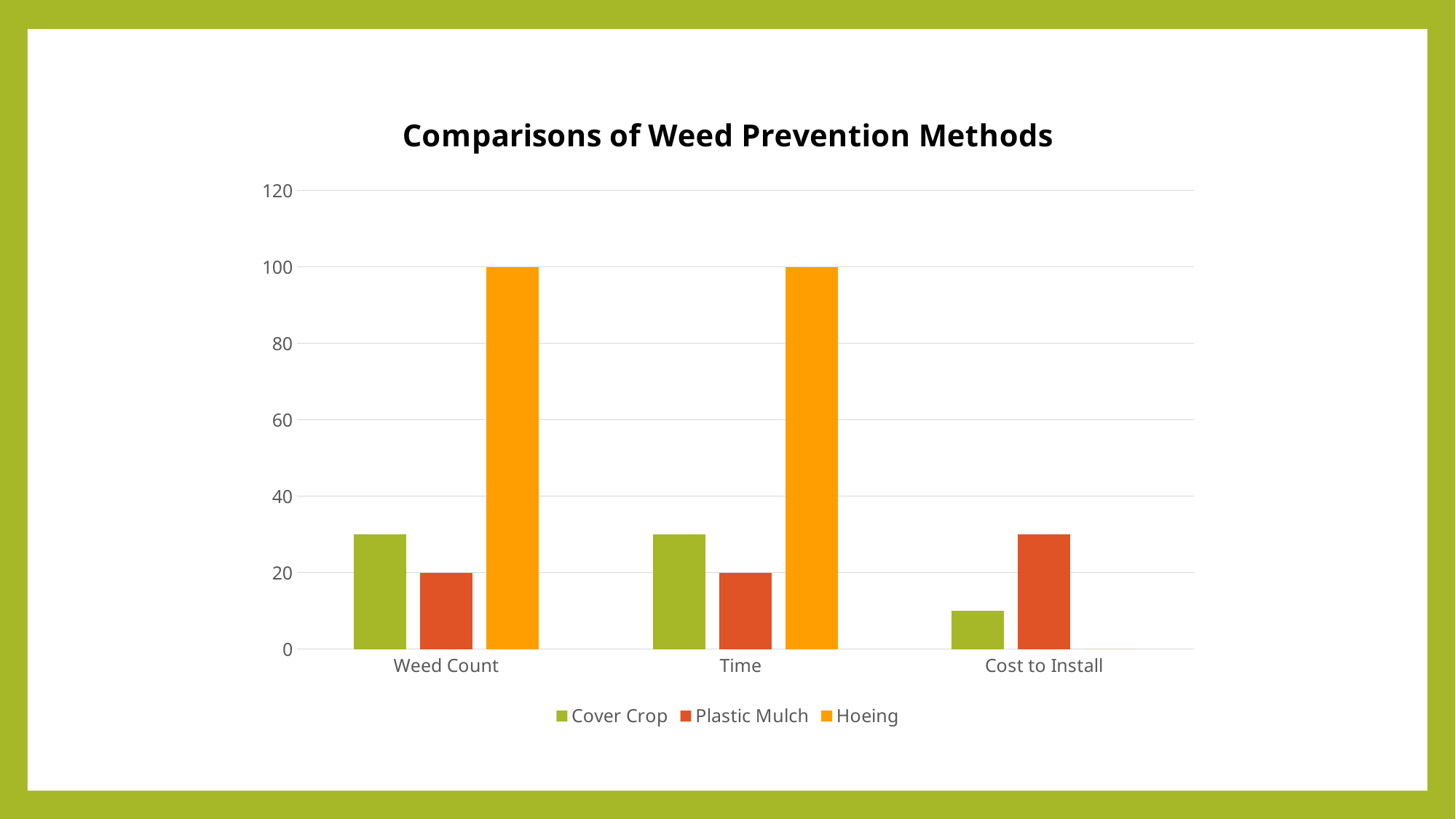
How many categories are shown on the x axis? 3 What is the difference between the Hoeing and Plastic Mulch values in the Weed Count category? 80 What is the value for Hoeing in the Weed Count category? 100 In the Time category, which is larger: Cover Crop or Plastic Mulch? Cover Crop How many series does the legend list? 3 Is the value for Cover Crop in the Weed Count category greater or less than 40? less What is the value for Hoeing in the Time category? 100 Is the value for Cover Crop in the Cost to Install category greater or less than 20? less What is the value for Plastic Mulch in the Time category? 20 Which method has the lowest value in the Weed Count category? Plastic Mulch Which method has the highest value in the Weed Count category? Hoeing Which method has the highest value in the Cost to Install category? Plastic Mulch